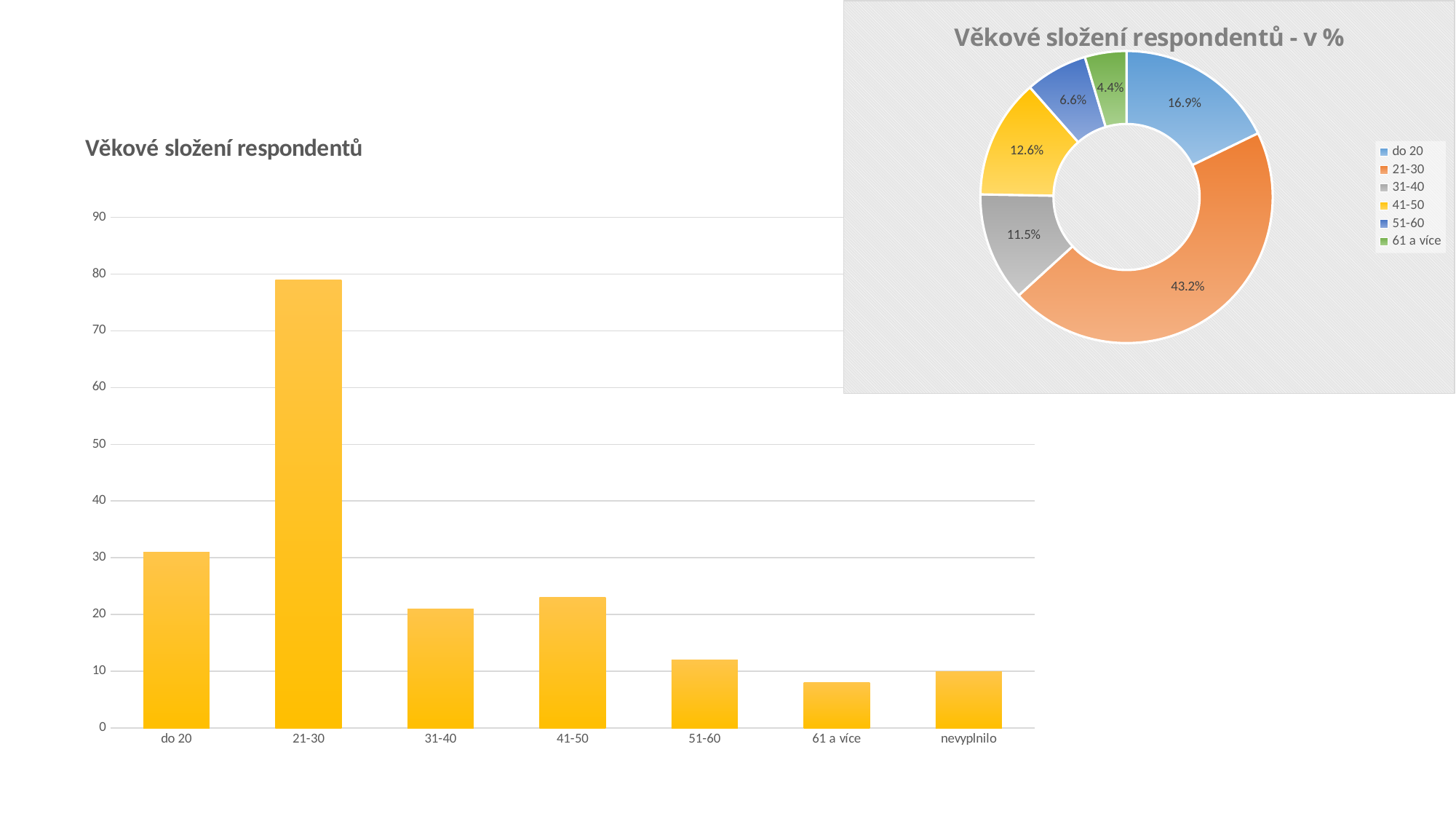
In the chart titled 'Věkové složení respondentů - v %', what is the share for 41-50? 12.6% In the chart titled 'Věkové složení respondentů - v %', which category has the smallest share? 61 a více In the chart titled 'Věkové složení respondentů - v %', what is the share for 61 a více? 4.4% In the chart titled 'Věkové složení respondentů' on the left, which category has the highest bar? 21-30 In the chart titled 'Věkové složení respondentů - v %', what is the share for 21-30? 43.2% What kind of chart is the one titled 'Věkové složení respondentů' on the left? bar chart In the chart titled 'Věkové složení respondentů - v %', what is the difference between the shares for do 20 and 31-40? 5.4% In the chart titled 'Věkové složení respondentů - v %', which is larger, the share for 41-50 or the share for 31-40? 41-50 In the chart titled 'Věkové složení respondentů' on the left, how many categories are shown on the x axis? 7 In the chart titled 'Věkové složení respondentů' on the left, is the value for do 20 greater or less than 30? greater In the chart titled 'Věkové složení respondentů' on the left, which category has the lowest bar? 61 a více In the chart titled 'Věkové složení respondentů - v %', how many entries does the legend list? 6